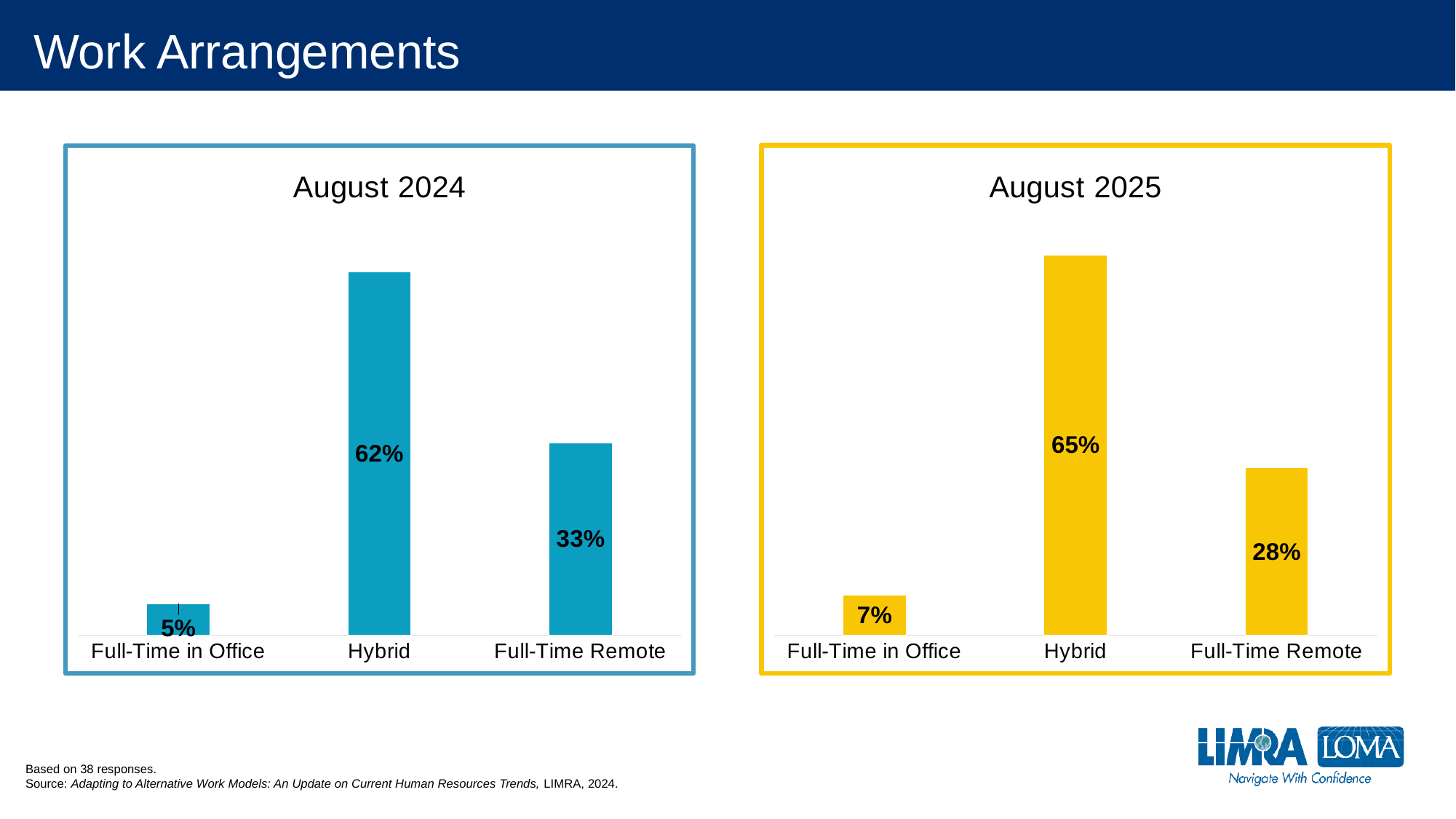
What kind of chart is the August 2024 chart? Bar chart In the August 2025 chart, what is the difference between Hybrid and Full-Time Remote? 37% How many categories are shown in the August 2025 chart? 3 In the August 2024 chart, what is the value for Full-Time in Office? 5% In the August 2024 chart, which category has the lowest value? Full-Time in Office What colour are the bars in the August 2025 chart? Yellow Which is larger: Full-Time Remote in the August 2024 chart or Full-Time Remote in the August 2025 chart? August 2024 What is the title of the chart on the right side of the slide? August 2025 In the August 2025 chart, what is the value for Full-Time Remote? 28% In the August 2024 chart, what is the difference between Full-Time Remote and Full-Time in Office? 28% In the August 2025 chart, which category has the highest value? Hybrid In the August 2024 chart, what is the value for Hybrid? 62%